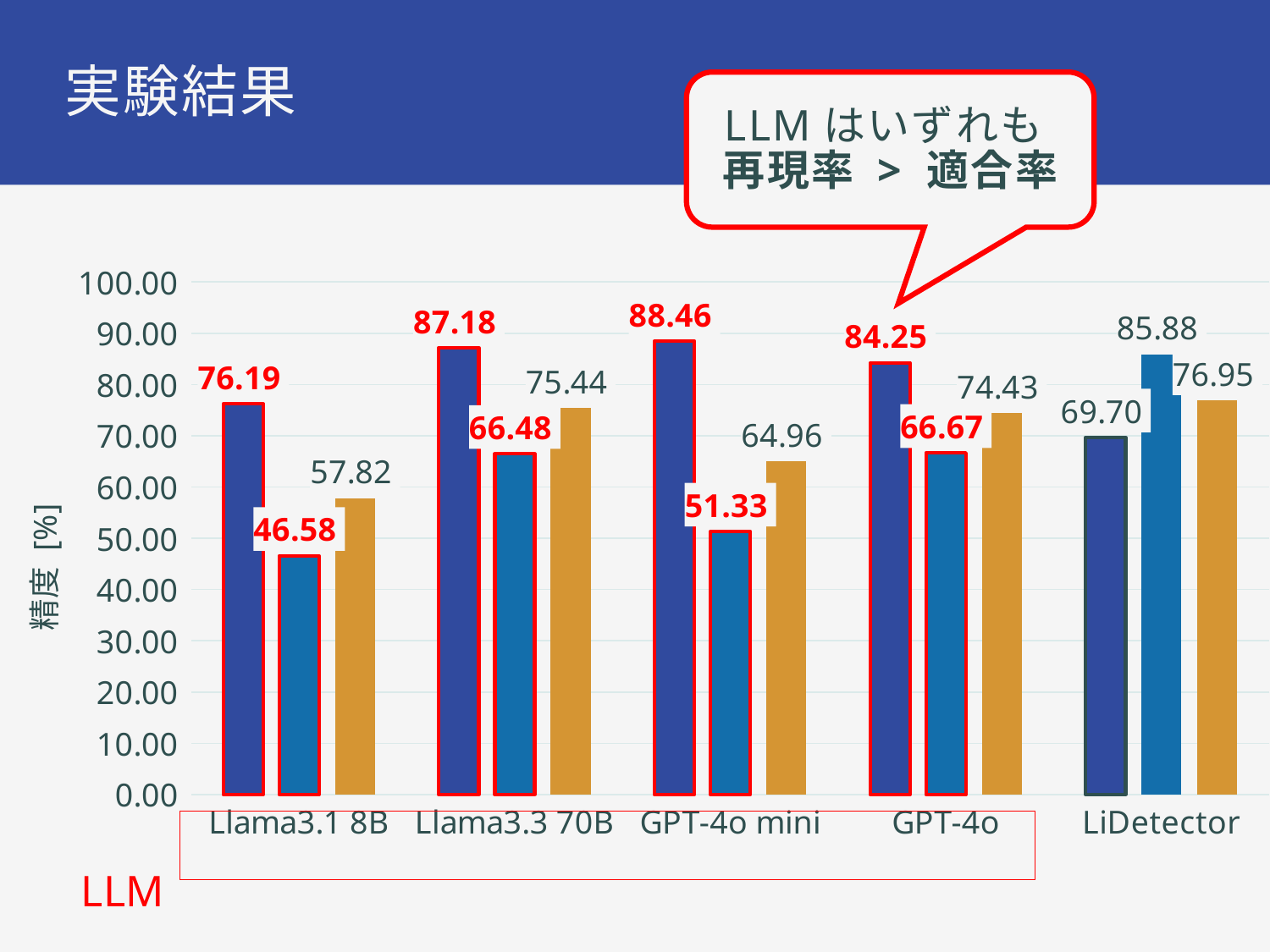
What is the label of the y axis of the chart? 精度 [%] For LiDetector, which is larger: the first (dark blue) bar or the second (light blue) bar? the second (light blue) bar What is the value of the second (light blue) bar for LiDetector? 85.88 What is the value of the third (orange) bar for Llama3.3 70B? 75.44 Which category has the lowest value for the second (light blue) bar? Llama3.1 8B What type of chart is shown on the slide? bar chart What is the value of the second (light blue) bar for GPT-4o mini? 51.33 What is the difference between the first (dark blue) bar and the second (light blue) bar for GPT-4o? 17.58 How many categories are shown on the x axis of the chart? 5 Which category has the highest value for the first (dark blue) bar? GPT-4o mini Which categories on the x axis are grouped under the label "LLM"? Llama3.1 8B, Llama3.3 70B, GPT-4o mini, GPT-4o What is the value of the first (dark blue) bar for Llama3.1 8B? 76.19